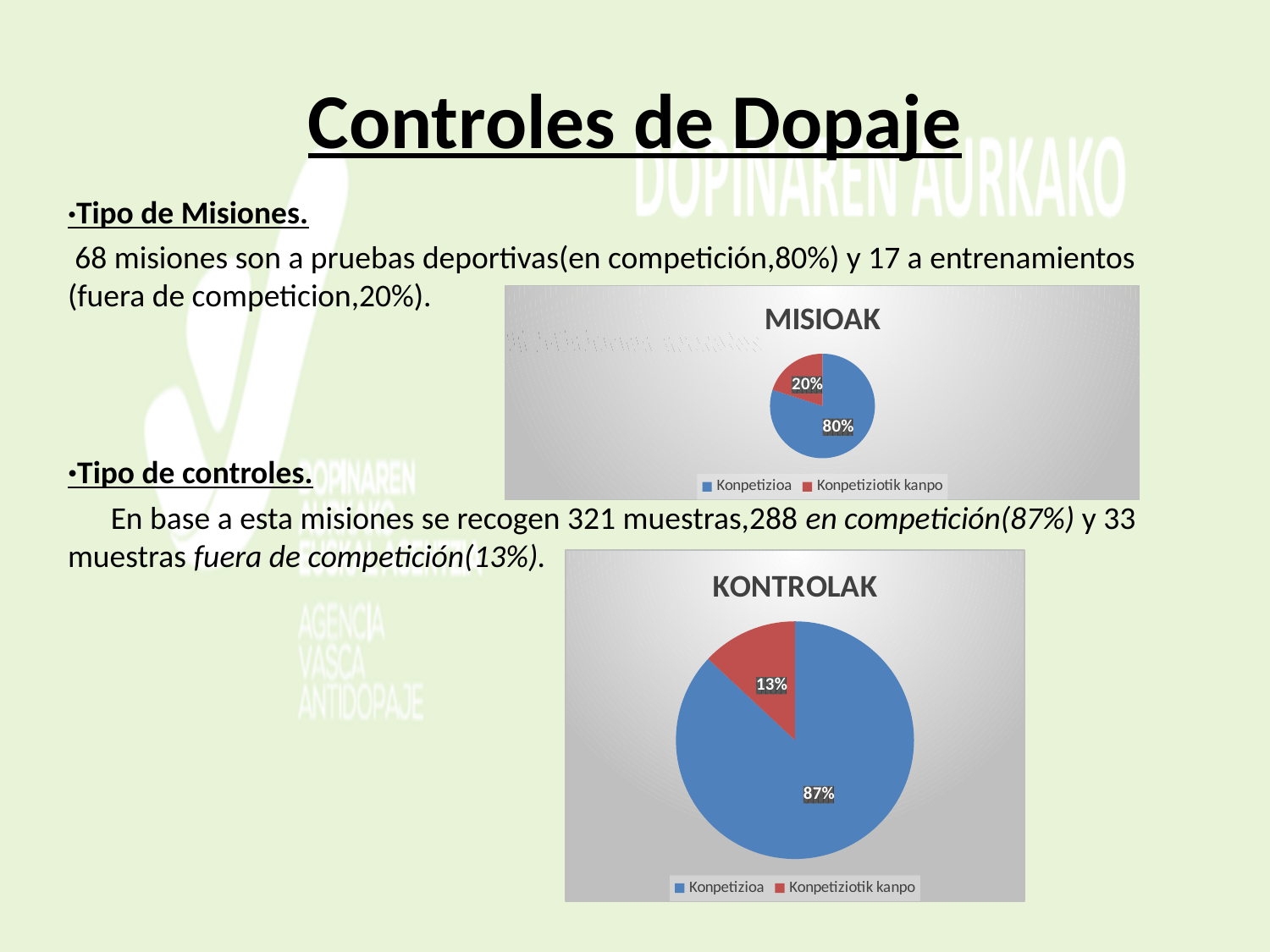
In the KONTROLAK chart, what is the difference between the Konpetizioa and Konpetiziotik kanpo shares? 74% What type of chart is the KONTROLAK chart? Pie chart In the MISIOAK chart, what is the difference between the Konpetizioa and Konpetiziotik kanpo shares? 60% In the KONTROLAK chart, what share does Konpetizioa have? 87% In the MISIOAK chart, what colour is the Konpetiziotik kanpo slice? Red In the MISIOAK chart, what share does Konpetiziotik kanpo have? 20% How many slices does the MISIOAK chart have? 2 How many entries does the legend of the KONTROLAK chart list? 2 In the KONTROLAK chart, which slice is the smallest? Konpetiziotik kanpo In the MISIOAK chart, which slice is the largest? Konpetizioa In the MISIOAK chart, what share does Konpetizioa have? 80%